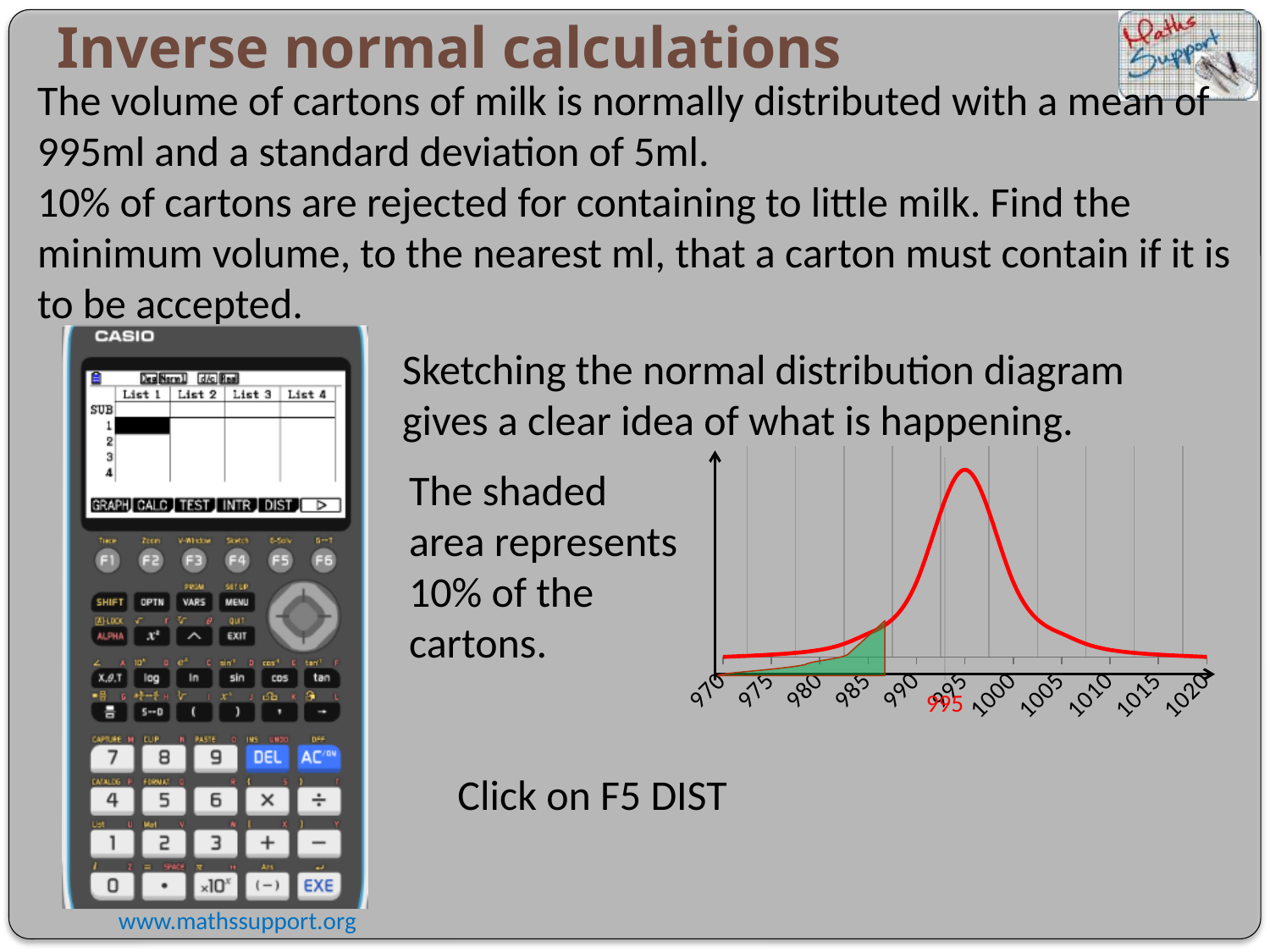
Does the curve rise or fall as x increases from 970 to 995? Rises How many labelled tick values are there on the x axis of the normal distribution diagram? 11 Is the shaded area on the left or the right side of the curve's peak? Left Is the height of the curve at 1000 greater or less than its height at 1015? Greater What is the step between consecutive labelled values on the x axis of the diagram? 5 Which x-axis label on the diagram is written in red? 995 What kind of chart is the diagram on the right of the slide? A line chart (normal distribution curve) What is the highest value labelled on the x axis of the normal distribution diagram? 1020 What is the lowest value labelled on the x axis of the normal distribution diagram? 970 Does the curve rise or fall as x increases from 995 to 1020? Falls At what x-axis value does the normal distribution curve reach its peak? 995 According to the slide, what percentage of the cartons does the shaded area represent? 10%